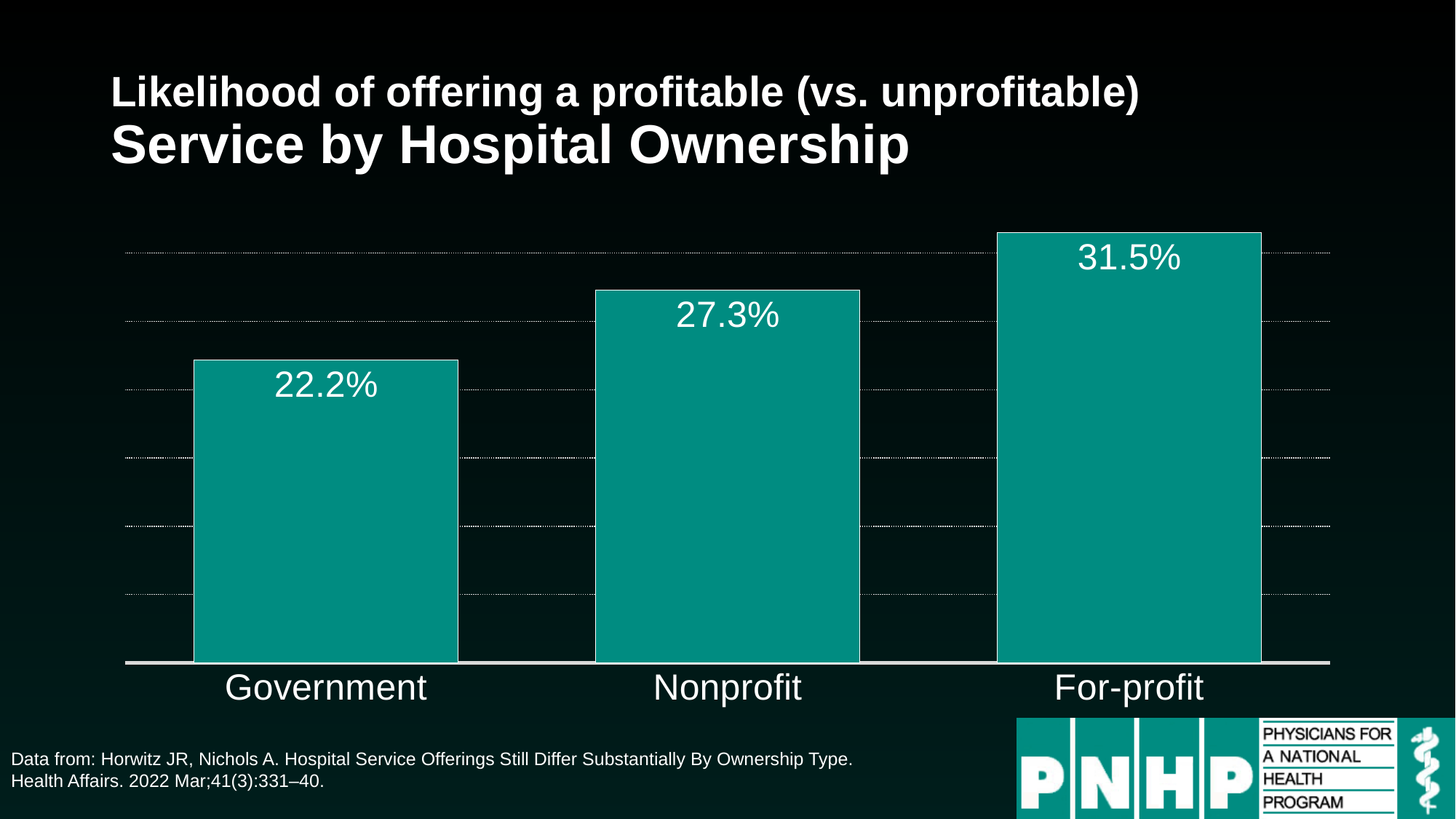
What is the difference between the Nonprofit and Government values? 5.1% What is the value for Government? 22.2% How many ownership categories are shown in the chart? 3 What is the difference between the For-profit and Government values? 9.3% What is the value for For-profit? 31.5% Which hospital ownership type has the lowest likelihood of offering a profitable service? Government Do the values rise or fall from Government to For-profit along the x axis? Rise Which is larger, the value for Nonprofit or the value for For-profit? For-profit What kind of chart is shown on the slide? Bar chart What is the value for Nonprofit? 27.3% What is the title of the chart? Likelihood of offering a profitable (vs. unprofitable) Service by Hospital Ownership Which hospital ownership type has the highest likelihood of offering a profitable service? For-profit